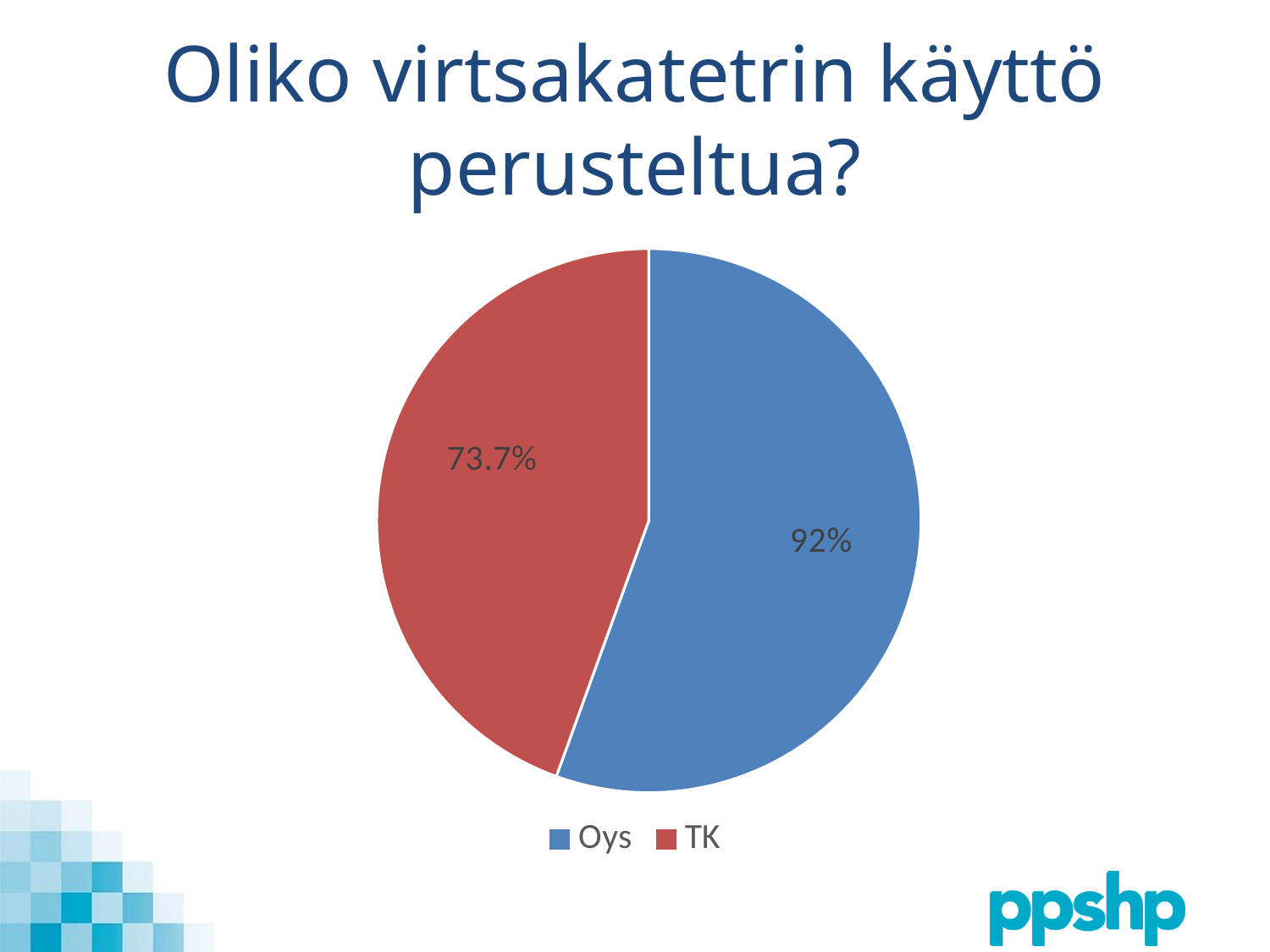
What colour is the slice for TK? red How many slices does the pie chart have? 2 What is the difference between the values for Oys and TK? 18.3 percentage points What is the value shown for Oys? 92% Which category has the highest value in the chart? Oys How many entries does the legend list? 2 What type of chart is shown on the slide? pie chart Which category has the higher value, Oys or TK? Oys Which category has the lowest value in the chart? TK What is the title of the slide? Oliko virtsakatetrin käyttö perusteltua? What is the value shown for TK? 73.7%